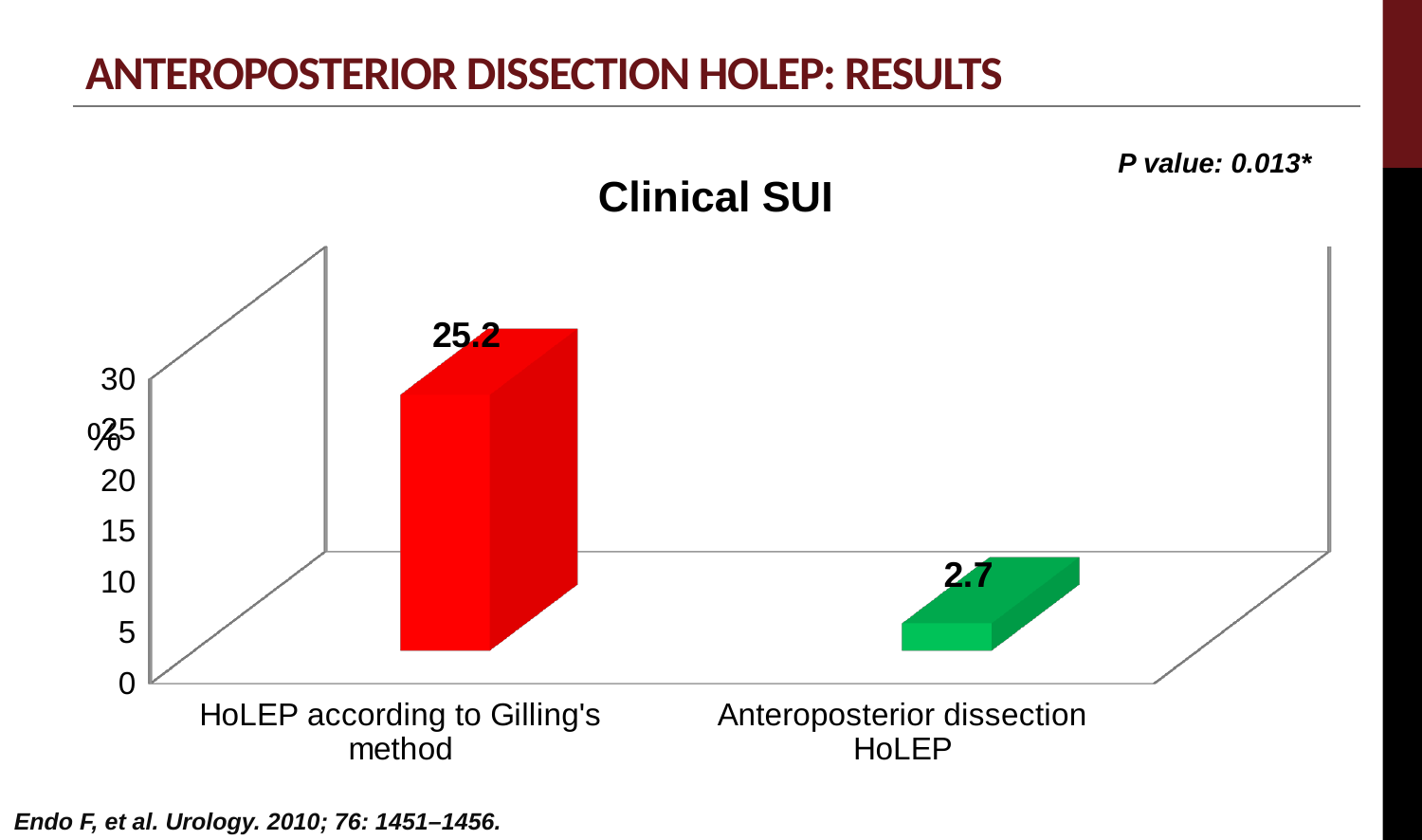
Is the value for HoLEP according to Gilling's method greater or less than 20? greater What is the difference between the values for HoLEP according to Gilling's method and Anteroposterior dissection HoLEP? 22.5 What colour is the bar for Anteroposterior dissection HoLEP? Green Which category has the highest value in the Clinical SUI chart? HoLEP according to Gilling's method What kind of chart is shown on the slide? Bar chart Which category has the lowest value in the Clinical SUI chart? Anteroposterior dissection HoLEP What is the value for HoLEP according to Gilling's method in the Clinical SUI chart? 25.2 Which is larger: the value for HoLEP according to Gilling's method or for Anteroposterior dissection HoLEP? HoLEP according to Gilling's method How many categories are shown in the Clinical SUI chart? 2 What is the title of the chart? Clinical SUI What is the value for Anteroposterior dissection HoLEP in the Clinical SUI chart? 2.7 Is the value for Anteroposterior dissection HoLEP greater or less than 5? less